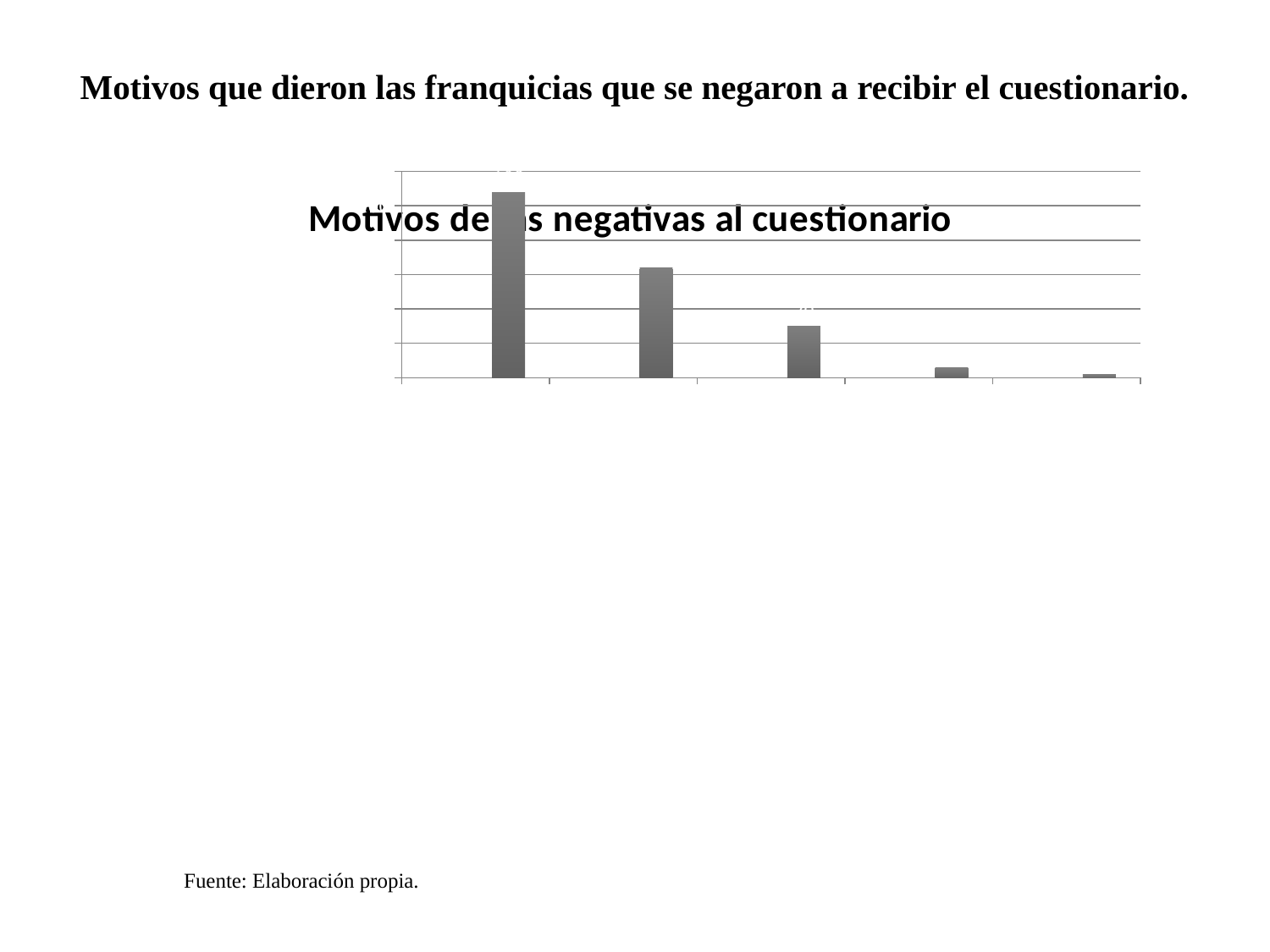
How many bars are plotted in the chart? 5 What kind of chart is shown on the slide? bar chart Which is taller, the fourth bar or the fifth bar? the fourth bar Which bar in the chart is the tallest? the first (leftmost) bar Which is taller, the third bar or the fourth bar? the third bar Which bar in the chart is the shortest? the last (rightmost) bar What colour are the bars in the chart? grey Which is taller, the first bar or the second bar? the first bar What is the title of the chart? Motivos de las negativas al cuestionario Do the bar values rise or fall from left to right across the chart? fall